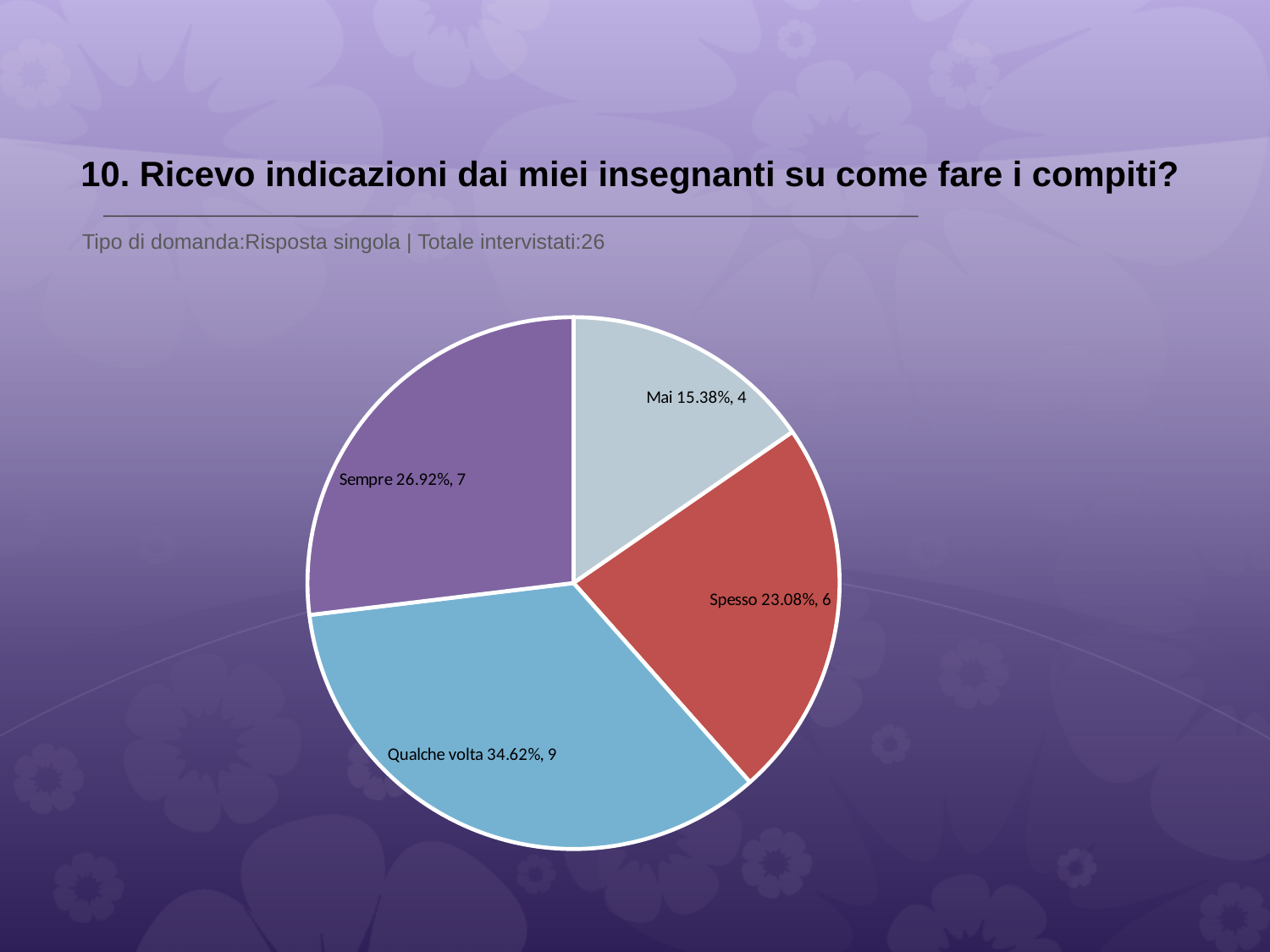
How many respondents answered 'Sempre'? 7 How many slices does the pie chart have? 4 What kind of chart is shown on the slide? pie chart Which category has the largest slice? Qualche volta What colour is the 'Spesso' slice? red What percentage share does the 'Spesso' slice have? 23.08% Which has more respondents, 'Sempre' or 'Spesso'? Sempre Which category has the smallest slice? Mai How many respondents answered 'Mai'? 4 What is the total number of respondents across all slices? 26 What is the difference in respondent count between 'Qualche volta' and 'Spesso'? 3 What percentage share does the 'Qualche volta' slice have? 34.62%